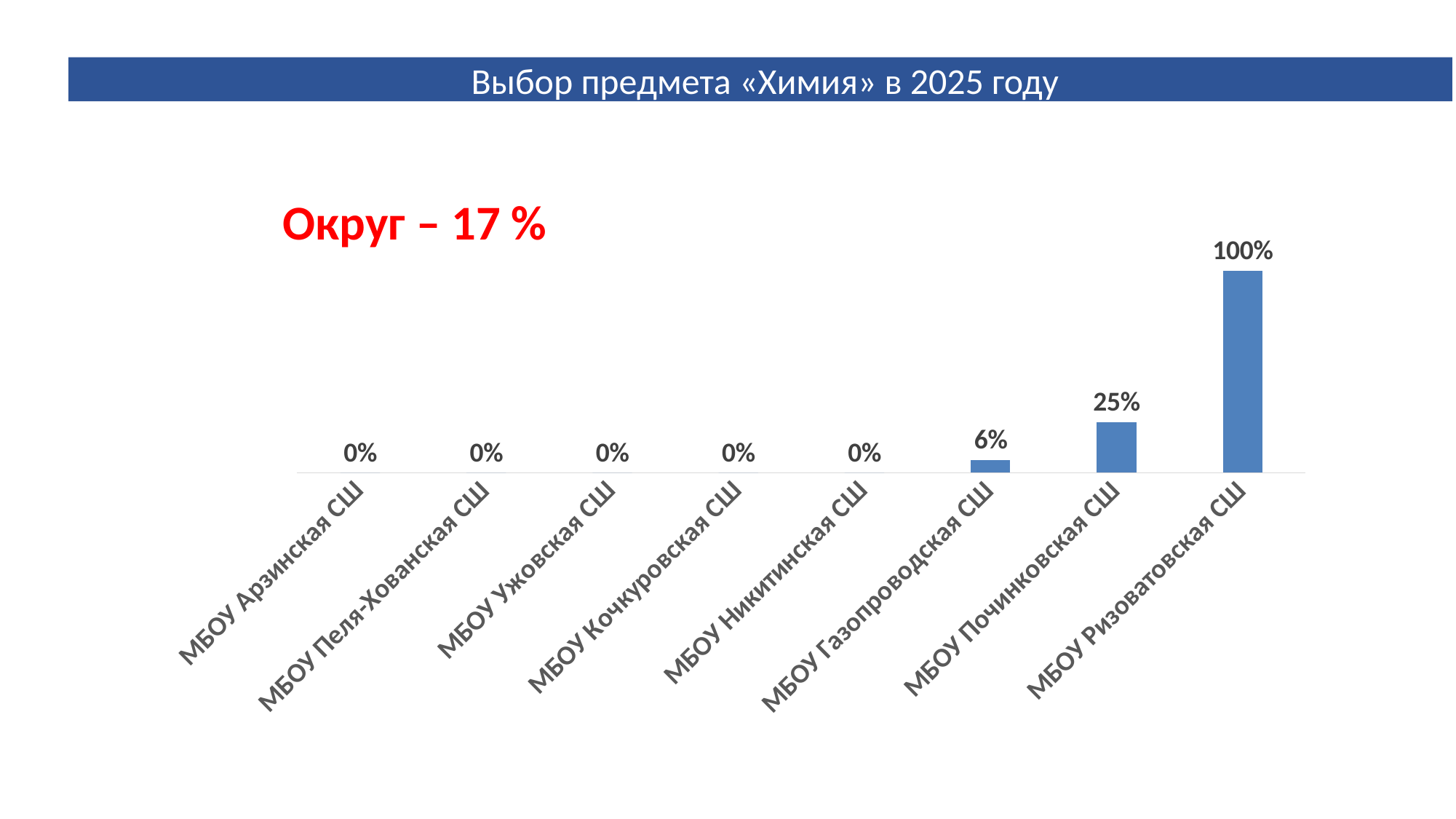
What is the value for МБОУ Никитинская СШ? 0% What is the title of the slide? Выбор предмета «Химия» в 2025 году What is the value for МБОУ Починковская СШ? 25% What kind of chart is shown on the slide? Bar chart What is the value for МБОУ Ризоватовская СШ? 100% Which school has the highest value? МБОУ Ризоватовская СШ How many schools have a value of 0%? 5 Which is larger, the value for МБОУ Газопроводская СШ or МБОУ Починковская СШ? МБОУ Починковская СШ What is the value for МБОУ Газопроводская СШ? 6% What is the difference between the values for МБОУ Ризоватовская СШ and МБОУ Починковская СШ? 75% How many schools are shown on the chart? 8 What is the difference between the values for МБОУ Починковская СШ and МБОУ Газопроводская СШ? 19%